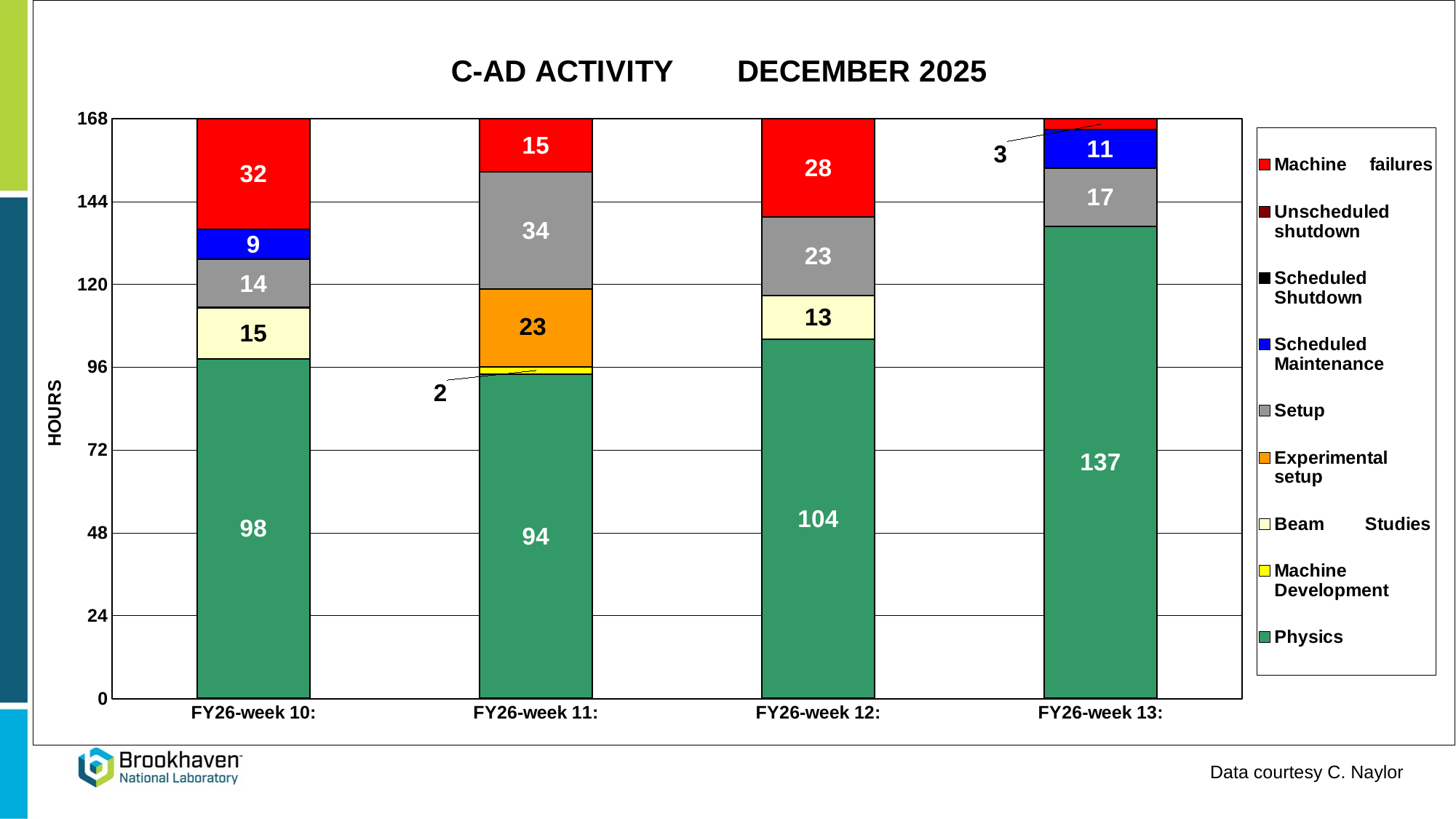
How many weeks (categories) are plotted on the x axis? 4 Which is larger: Setup hours in FY26-week 11 or Setup hours in FY26-week 12? FY26-week 11 Which week has the lowest number of Machine failures hours? FY26-week 13 How many Machine failures hours are shown for FY26-week 10? 32 How many series does the legend list? 9 What is the difference in Physics hours between FY26-week 13 and FY26-week 10? 39 What is the total height of the stacked bar for FY26-week 10? 168 How many Scheduled Maintenance hours are shown for FY26-week 13? 11 How many Experimental setup hours are shown for FY26-week 11? 23 How many Physics hours are shown for FY26-week 12? 104 What kind of chart is shown on the slide? Stacked bar chart Which week has the highest number of Physics hours? FY26-week 13